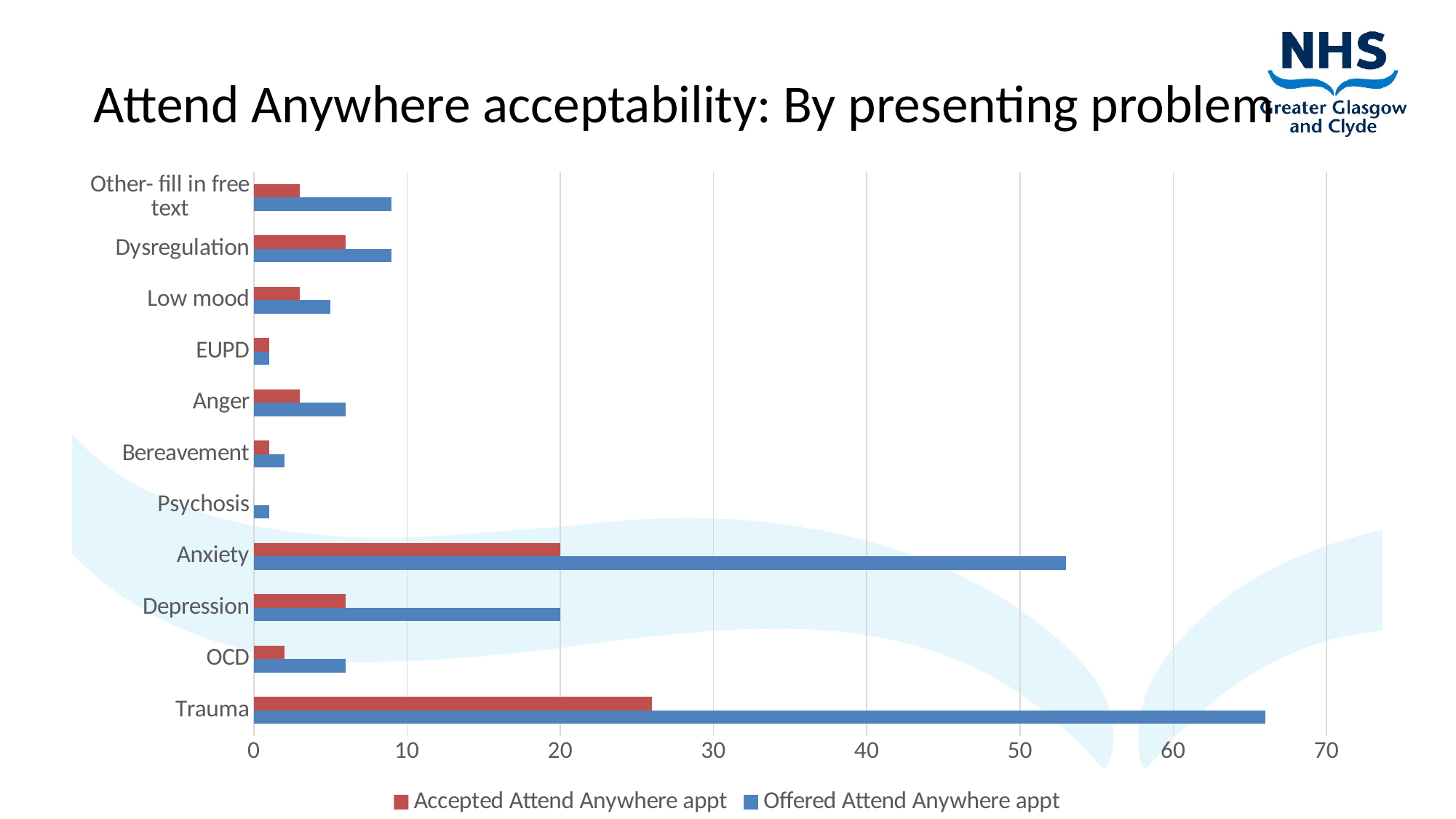
Which presenting problem has the highest value for Offered Attend Anywhere appt? Trauma What kind of chart is shown on the slide? bar chart Is the Offered Attend Anywhere appt value for Trauma greater or less than 60? greater Which presenting problem has the highest value for Accepted Attend Anywhere appt? Trauma What is the Accepted Attend Anywhere appt value for Anxiety? 20 How many presenting problem categories are shown on the chart? 11 What colour are the bars for Offered Attend Anywhere appt? blue Which is larger: the Offered Attend Anywhere appt value for Trauma or for Anxiety? Trauma Is the Offered Attend Anywhere appt value for Anxiety greater or less than 50? greater Is the Accepted Attend Anywhere appt value for Depression greater or less than 10? less What is the Offered Attend Anywhere appt value for Depression? 20 How many series does the legend list? 2